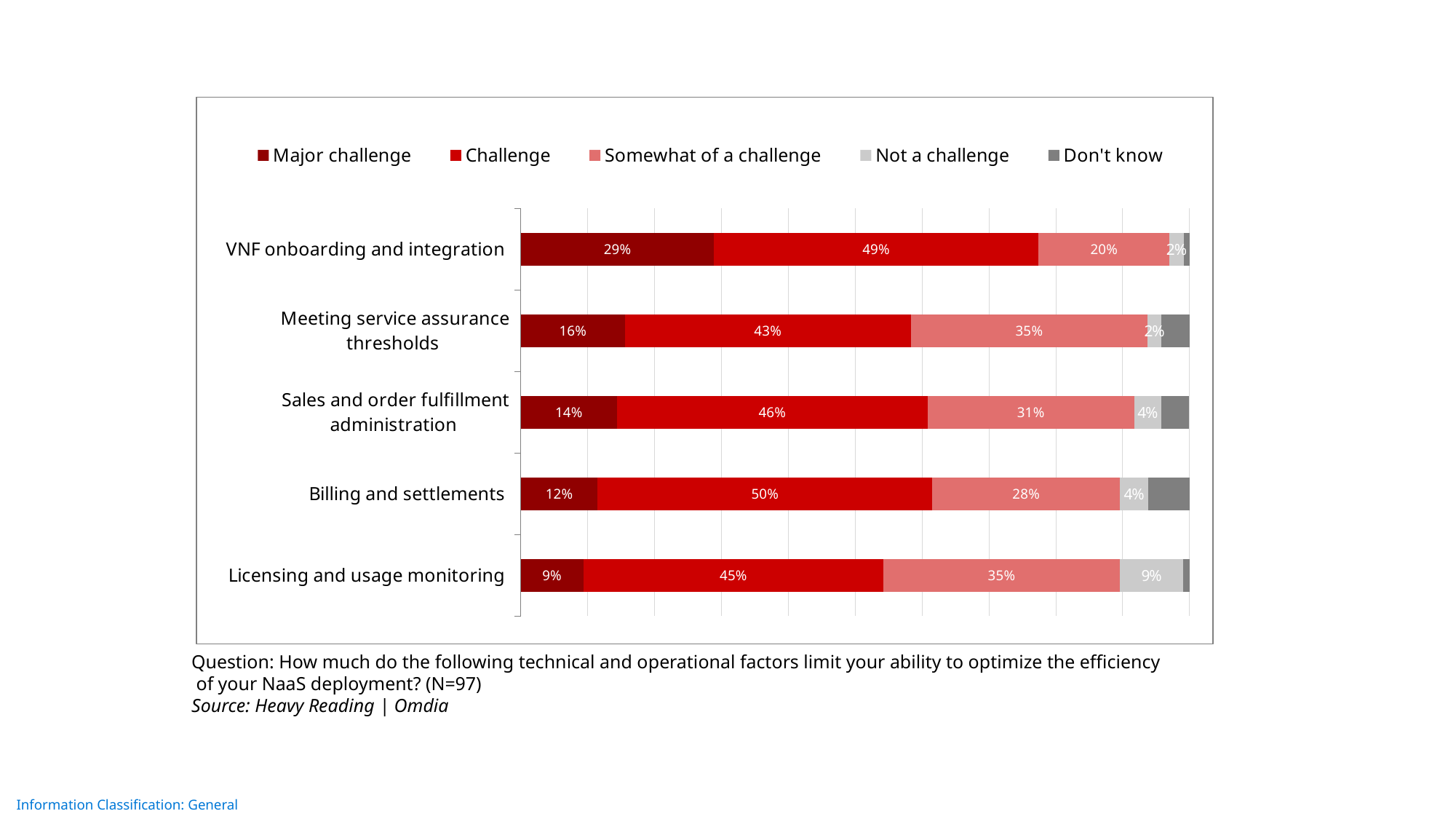
What is the 'Challenge' value for Billing and settlements? 50% What is the difference in 'Major challenge' percentage between VNF onboarding and integration and Meeting service assurance thresholds? 13 percentage points What is the 'Somewhat of a challenge' value for Meeting service assurance thresholds? 35% Which factor has the lowest 'Major challenge' percentage? Licensing and usage monitoring How many series does the legend list? 5 Which factor has the highest 'Major challenge' percentage? VNF onboarding and integration Which factor has the highest 'Challenge' percentage? Billing and settlements How many factors (categories) are shown in the chart? 5 Which has a larger 'Somewhat of a challenge' value: Sales and order fulfillment administration or Billing and settlements? Sales and order fulfillment administration What kind of chart is shown on the slide? Stacked bar chart What percentage of respondents rated VNF onboarding and integration as a major challenge? 29% What percentage said Licensing and usage monitoring is not a challenge? 9%